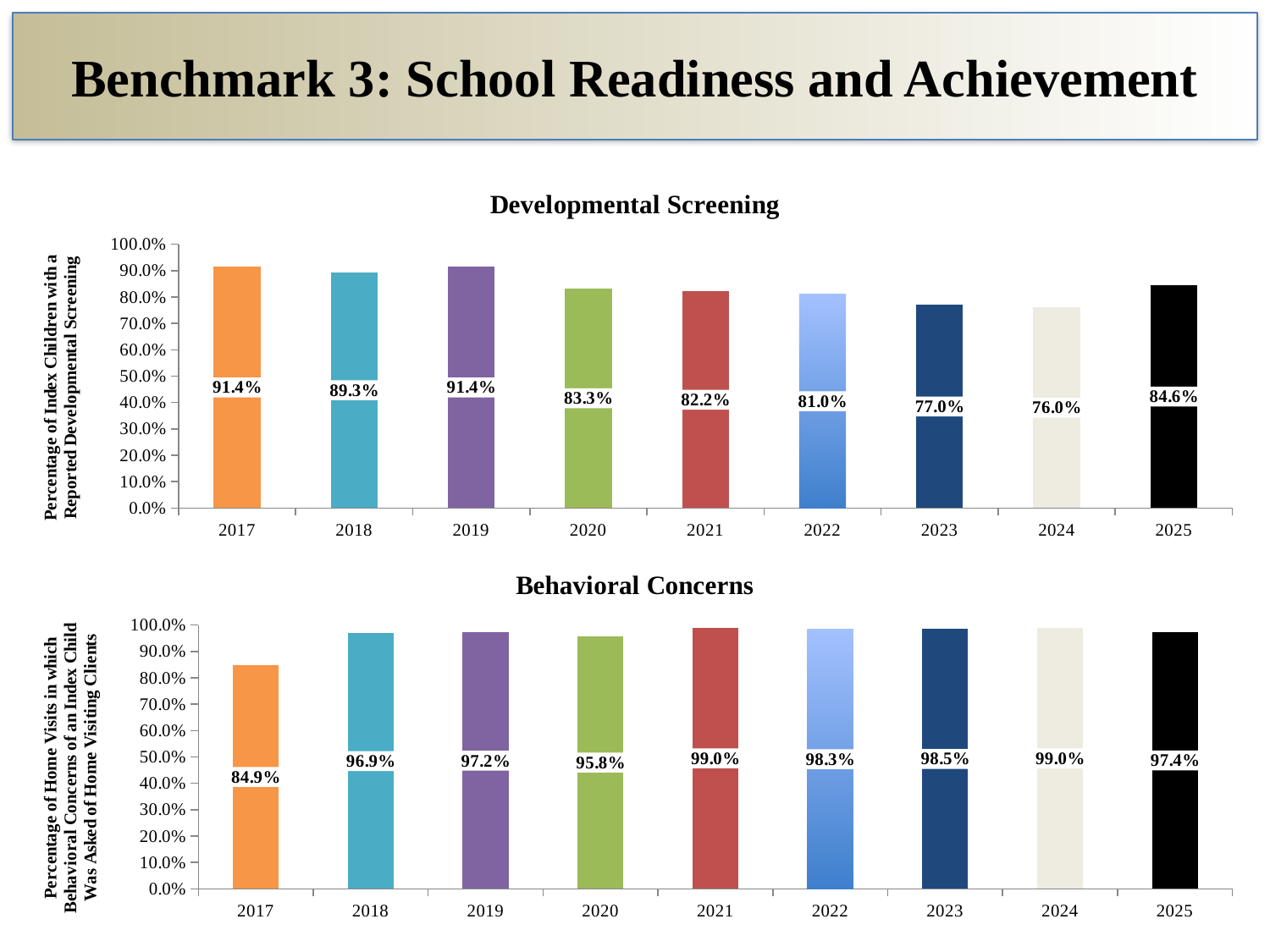
What kind of chart is the Developmental Screening chart? Bar chart In the Behavioral Concerns chart, is the value for 2018 greater or less than 90.0%? greater In the Behavioral Concerns chart, what is the value for 2022? 98.3% In the Behavioral Concerns chart, which is larger, the value for 2019 or the value for 2020? 2019 In the Developmental Screening chart, what is the value for 2020? 83.3% In the Behavioral Concerns chart, which year has the lowest value? 2017 What is the title of the lower chart on the slide? Behavioral Concerns In the Developmental Screening chart, is the value for 2023 greater or less than 80.0%? less In the Behavioral Concerns chart, what is the difference between the 2021 value and the 2017 value? 14.1% In the Developmental Screening chart, how many years are shown on the x axis? 9 In the Developmental Screening chart, what is the difference between the 2017 value and the 2024 value? 15.4% In the Developmental Screening chart, which year has the lowest value? 2024